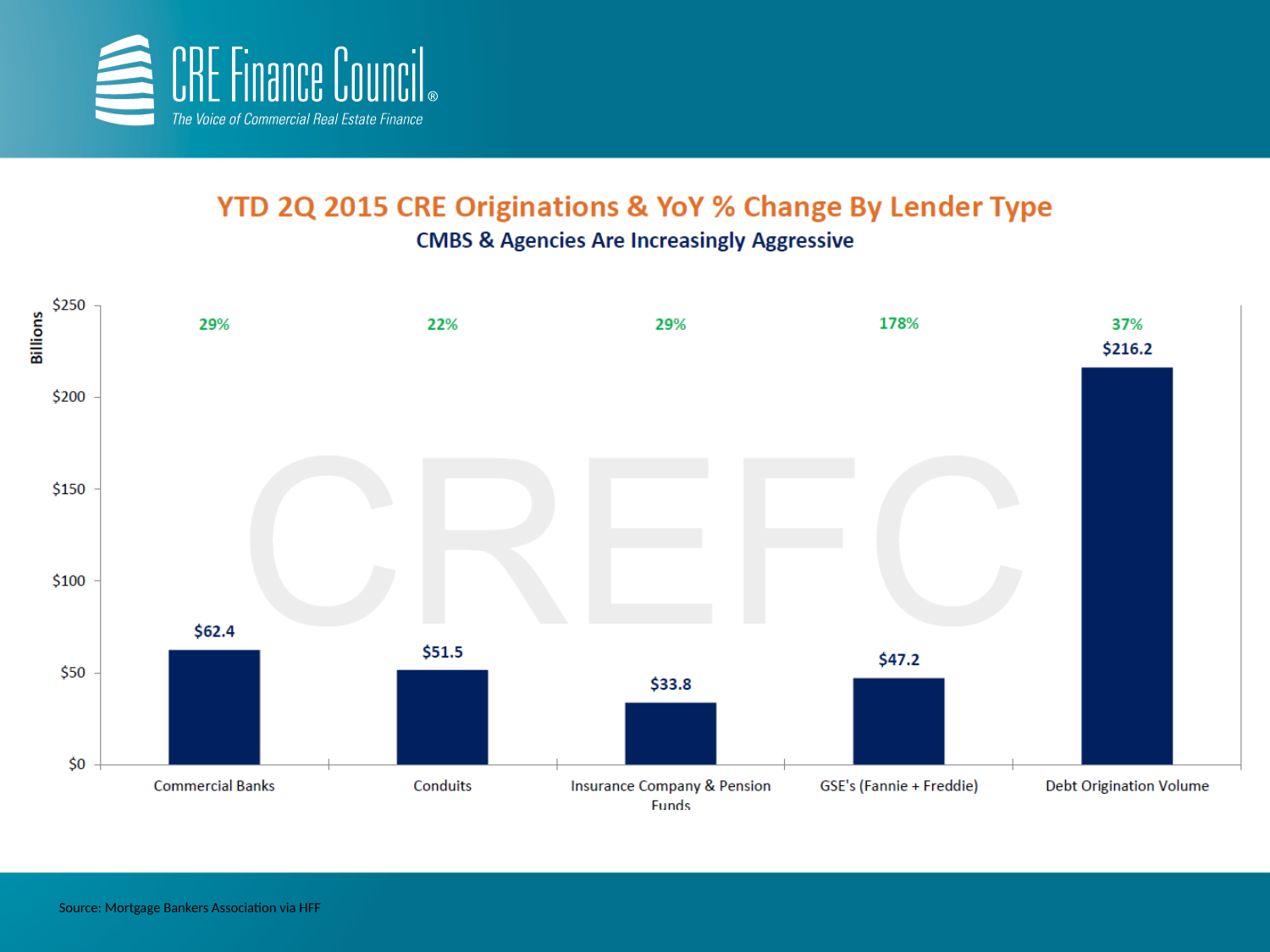
What is the value for Conduits? $51.5 What is the difference between the values for Commercial Banks and Conduits? $10.9 Which category has the lowest value? Insurance Company & Pension Funds What is the YoY % change shown for GSE's (Fannie + Freddie)? 178% Which category has the highest value? Debt Origination Volume What is the value for Insurance Company & Pension Funds? $33.8 Which is larger, the value for Conduits or the value for GSE's (Fannie + Freddie)? Conduits What is the value for GSE's (Fannie + Freddie)? $47.2 How many categories are shown on the x axis? 5 Is the value for Debt Origination Volume greater or less than $200? greater What kind of chart is this? Bar chart What is the value for Commercial Banks? $62.4